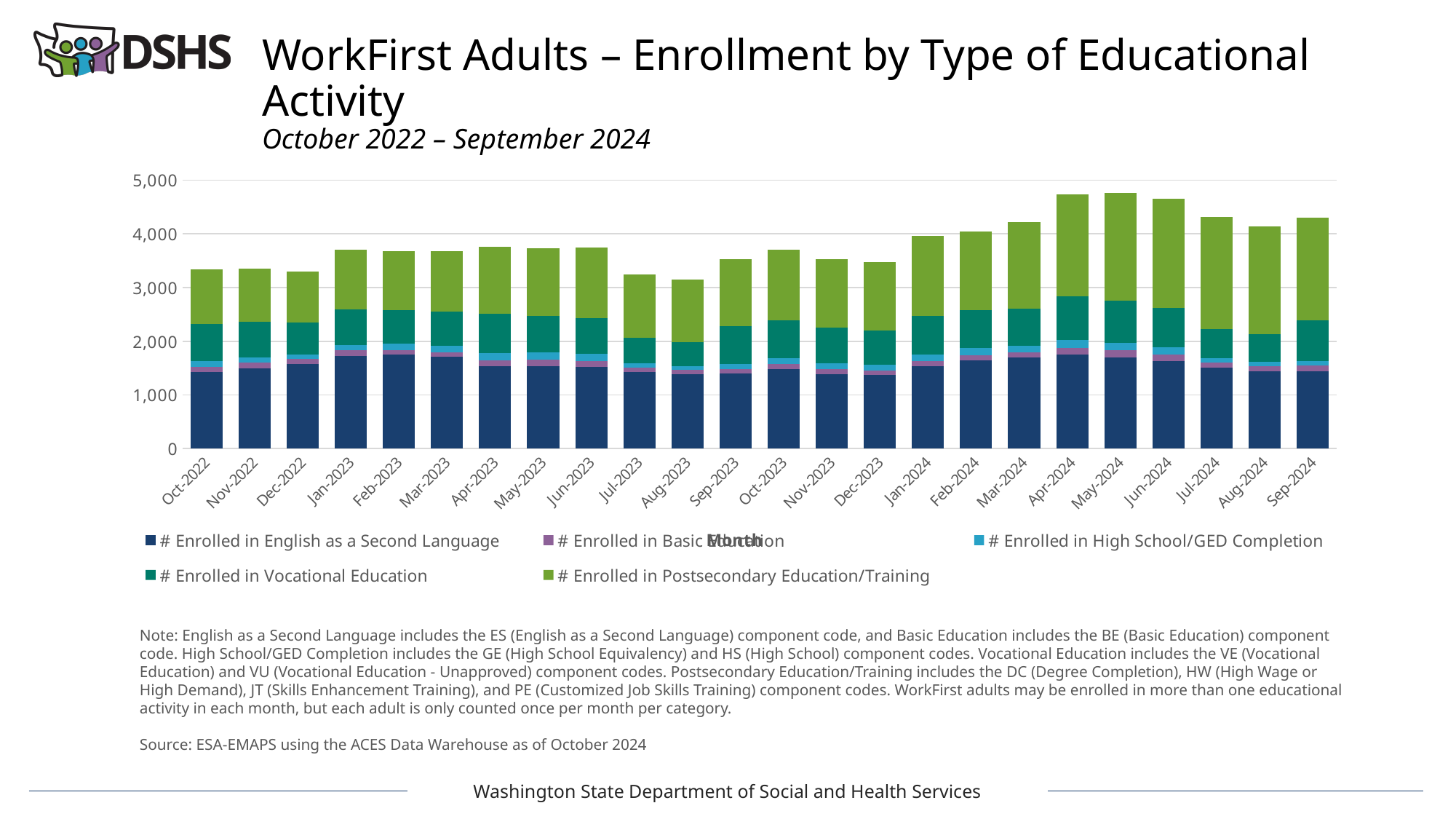
What kind of chart is shown on the slide? Stacked bar chart How many series does the legend list? 5 Is the total enrollment for Sep-2024 greater or less than 4,000? greater Is the total enrollment for Oct-2022 greater or less than 3,000? greater Which series is shown in green at the top of each stacked bar? # Enrolled in Postsecondary Education/Training Is the total enrollment for Aug-2023 greater or less than 4,000? less What period does the chart subtitle say the data covers? October 2022 – September 2024 Which month has the larger total enrollment, Jun-2024 or Aug-2023? Jun-2024 Which month has the larger total enrollment, Apr-2024 or Oct-2022? Apr-2024 How many months (bars) are plotted on the chart? 24 Do the total bar heights rise or fall from Jan-2024 to May-2024? rise